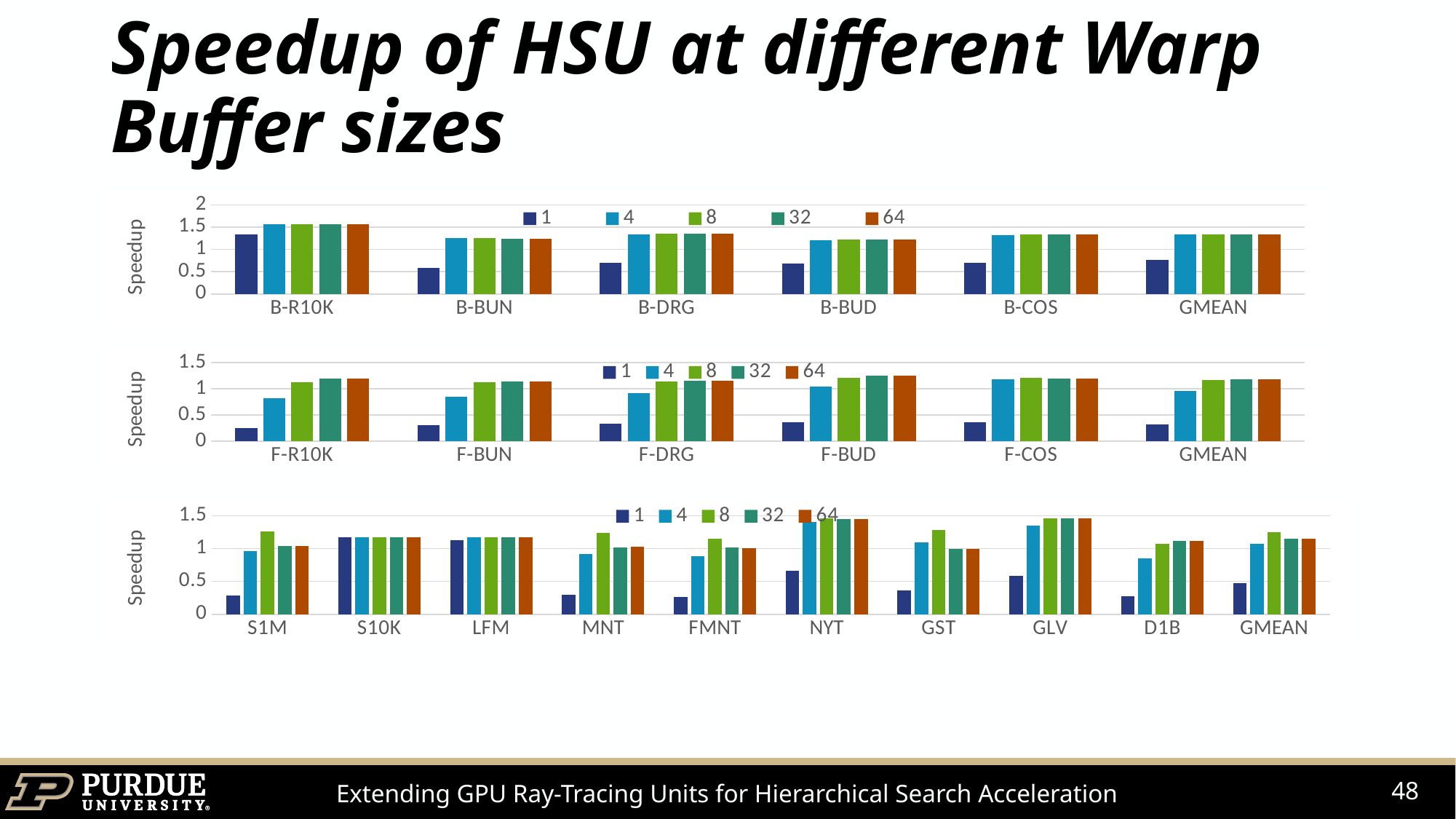
How many categories are shown on the x axis of the middle chart? 6 What kind of chart is the top chart? bar chart How many series does the legend of the top chart list? 5 How many charts are on the slide? 3 In the middle chart, is the value for series 1 at F-BUD greater or less than 0.5? less In the top chart, is the value for series 1 at B-BUN greater or less than 1? less In the bottom chart, is the value for series 8 at NYT greater or less than 1? greater How many categories are shown on the x axis of the bottom chart? 10 What is the label on the y axis of the charts? Speedup In the top chart, which category has the highest value for series 1? B-R10K In the bottom chart, which is larger for series 1: S10K or S1M? S10K